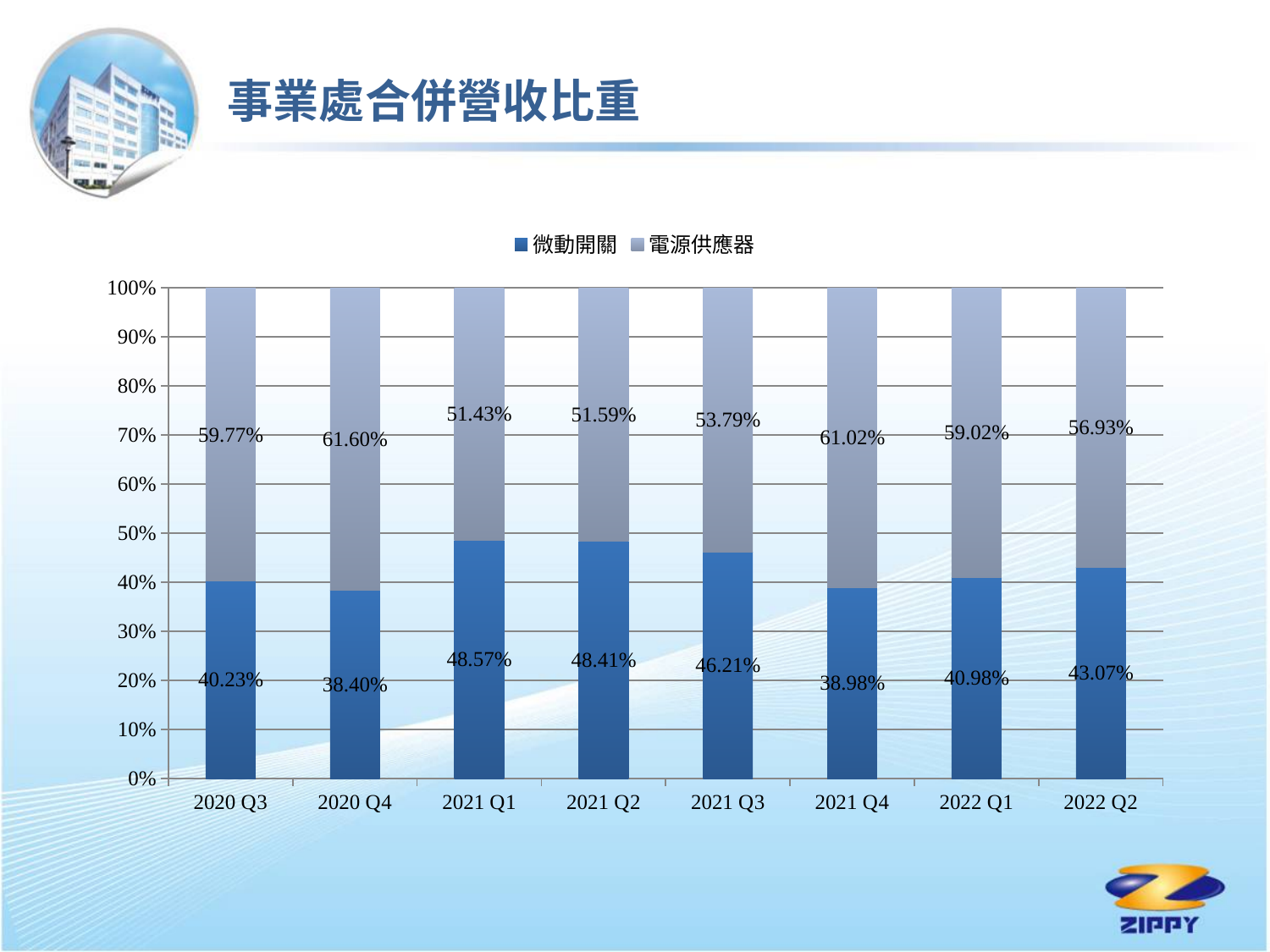
How many quarters are shown on the x axis? 8 What is the value for 微動開關 in 2021 Q1? 48.57% In which quarter is the 微動開關 share highest? 2021 Q1 What is the value for 微動開關 in 2022 Q2? 43.07% What is the difference between the 電源供應器 share and the 微動開關 share in 2021 Q3? 7.58% What is the value for 電源供應器 in 2020 Q4? 61.60% How many series does the legend list? 2 What is the total of the stacked bar for 2021 Q4? 100% In which quarter is the 微動開關 share lowest? 2020 Q4 In which quarter is the 電源供應器 share highest? 2020 Q4 Which is larger in 2022 Q1: the 微動開關 share or the 電源供應器 share? 電源供應器 What kind of chart is shown on the slide? Stacked bar chart